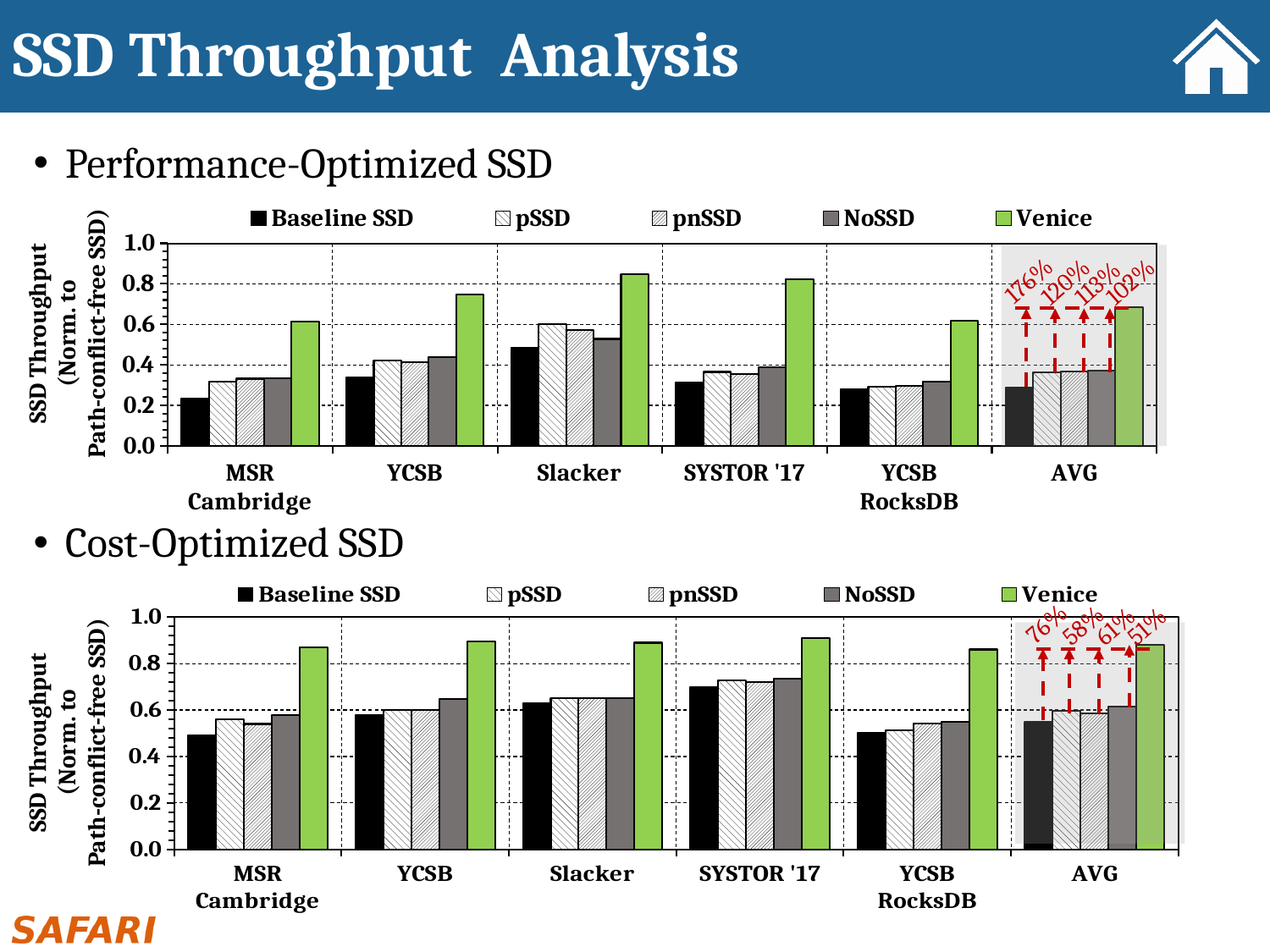
In the Performance-Optimized SSD chart, what improvement percentage is annotated for Venice over Baseline SSD at AVG? 176% In the Cost-Optimized SSD chart, what colour represents the Venice series in the legend? green In the Performance-Optimized SSD chart, how many series does the legend list? 5 In the Cost-Optimized SSD chart, how many workload categories are shown on the x axis? 6 In the Performance-Optimized SSD chart, which is larger: the Venice value for SYSTOR '17 or the Venice value for YCSB RocksDB? SYSTOR '17 In the Cost-Optimized SSD chart, what improvement percentage is annotated for Venice over NoSSD at AVG? 51% In the Performance-Optimized SSD chart, is the Venice value for Slacker greater or less than 0.8? greater In the Cost-Optimized SSD chart, is the Venice value for SYSTOR '17 greater or less than 0.8? greater In the Cost-Optimized SSD chart, is the Baseline SSD value for MSR Cambridge greater or less than 0.6? less In the Performance-Optimized SSD chart, which series has the highest throughput for Slacker? Venice In the Performance-Optimized SSD chart, what kind of chart is shown? bar chart